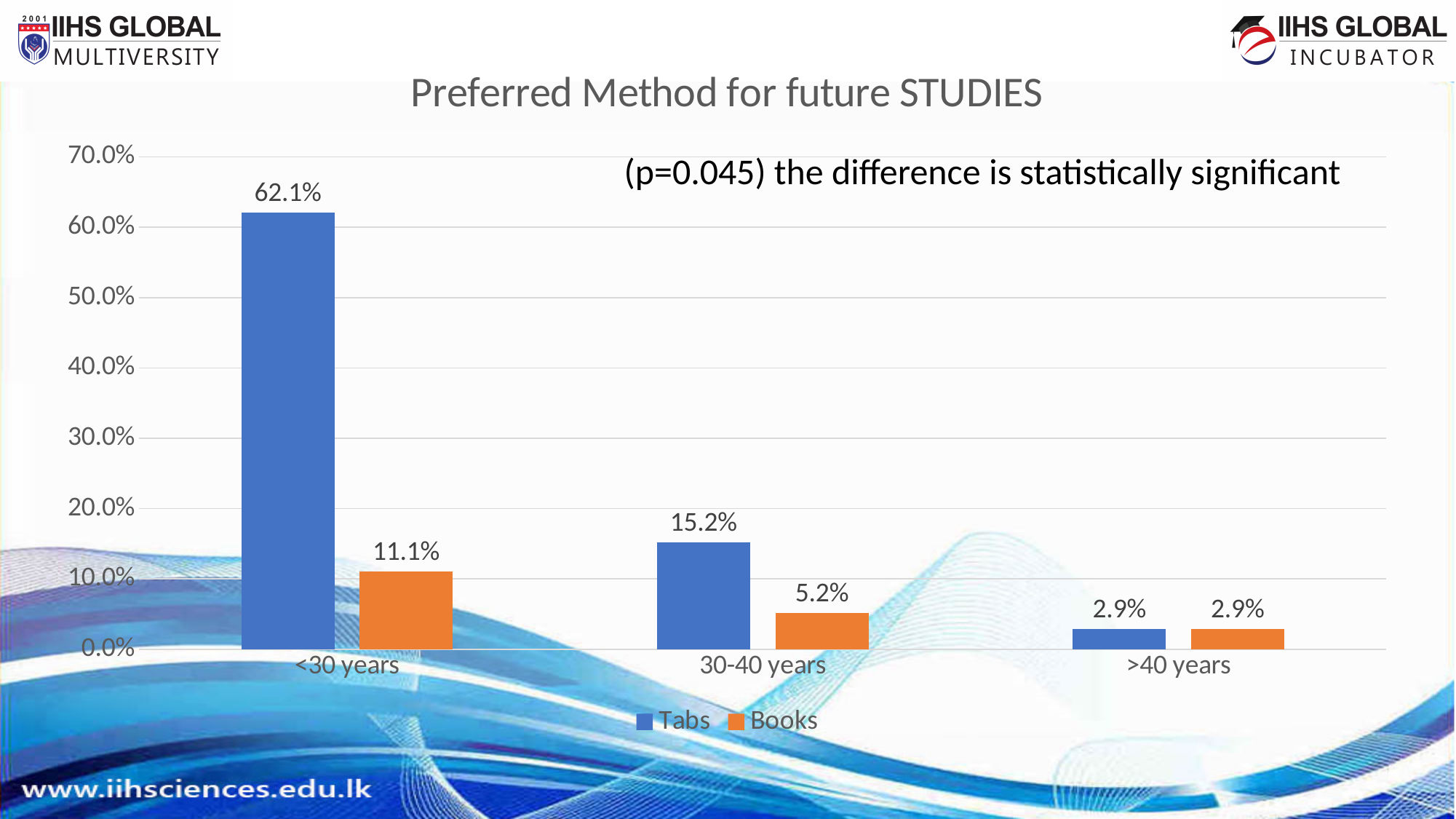
Which age group has the highest value for Tabs? <30 years What is the value for Books in the <30 years group? 11.1% What is the difference between Tabs and Books in the <30 years group? 51.0% Which age group has the lowest value for Books? >40 years How many age groups are shown on the x axis? 3 What is the difference between Tabs and Books in the 30-40 years group? 10.0% Which is larger in the 30-40 years group, Tabs or Books? Tabs What kind of chart is shown on the slide? Bar chart What is the value for Books in the 30-40 years group? 5.2% What is the value for Tabs in the <30 years group? 62.1% How many series does the legend list? 2 What is the title of the chart? Preferred Method for future STUDIES